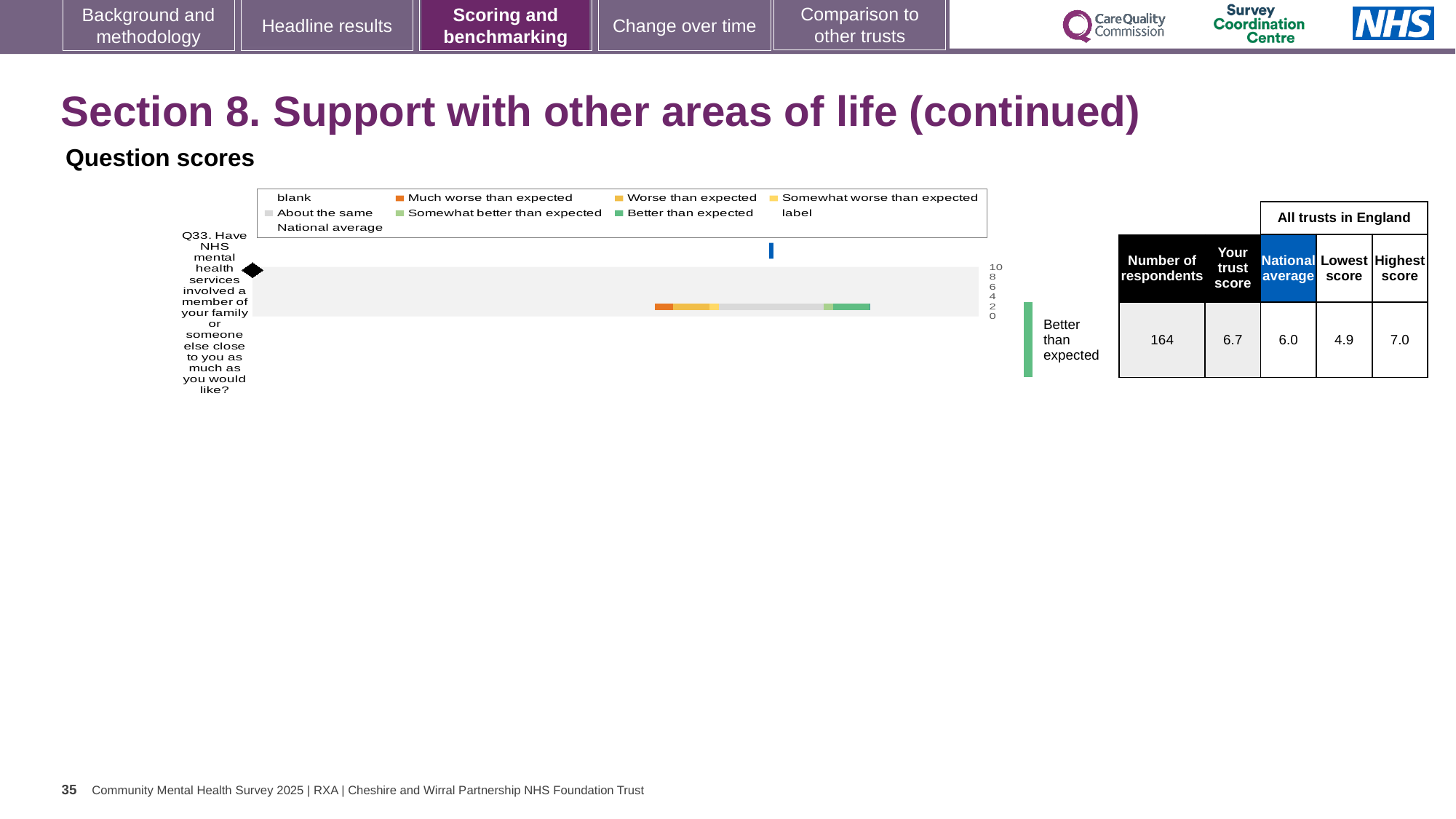
Which is larger for Q33: the trust's score or the national average? the trust's score Which benchmark category label is shown next to the bar for Q33? Better than expected Which colour in the legend represents 'Better than expected'? green How many respondents answered Q33? 164 What is the highest score among all trusts in England for Q33? 7.0 By how much does the trust's score for Q33 exceed the national average? 0.7 What is the difference between the highest and lowest trust scores for Q33? 2.1 What kind of chart is used to show the Q33 question score? bar chart How many survey questions are plotted on the chart? 1 What is the national average score for Q33? 6.0 What is the trust's score for Q33 according to the table? 6.7 What is the lowest score among all trusts in England for Q33? 4.9